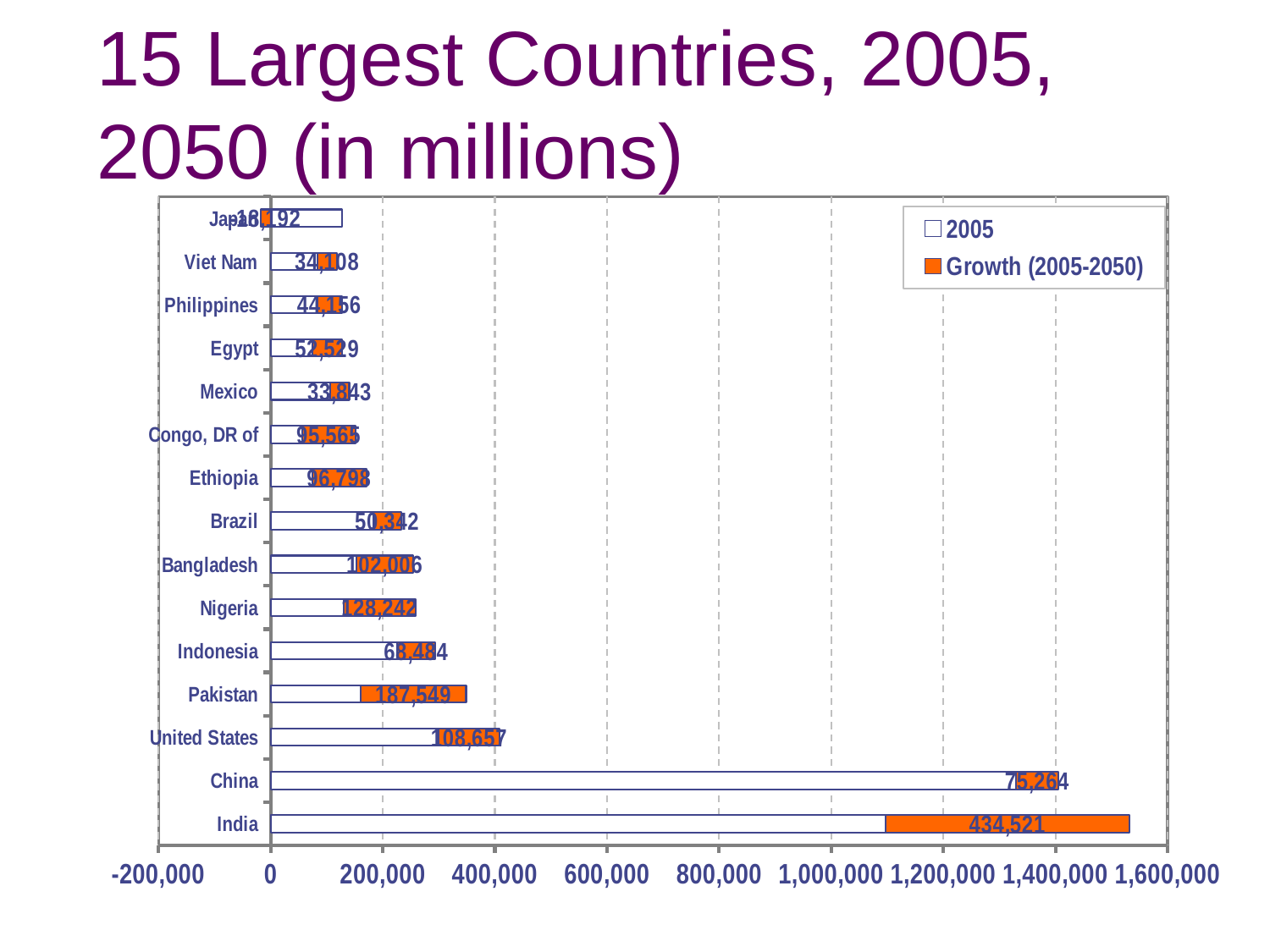
What is the Growth (2005-2050) value for the United States? 108,657 Is the 2005 value for China greater or less than 1,200,000? greater Which has the larger Growth (2005-2050) value, Pakistan or Nigeria? Pakistan Which country has the largest Growth (2005-2050) value? India What is the Growth (2005-2050) value for Nigeria? 128,242 What is the Growth (2005-2050) value for Pakistan? 187,549 What is the difference between the Growth (2005-2050) values for India and China? 359,257 What is the difference between the Growth (2005-2050) values for Pakistan and the United States? 78,892 How many series does the legend list? 2 What is the Growth (2005-2050) value for India? 434,521 What kind of chart is shown on the slide? bar chart How many countries are shown in the chart? 15